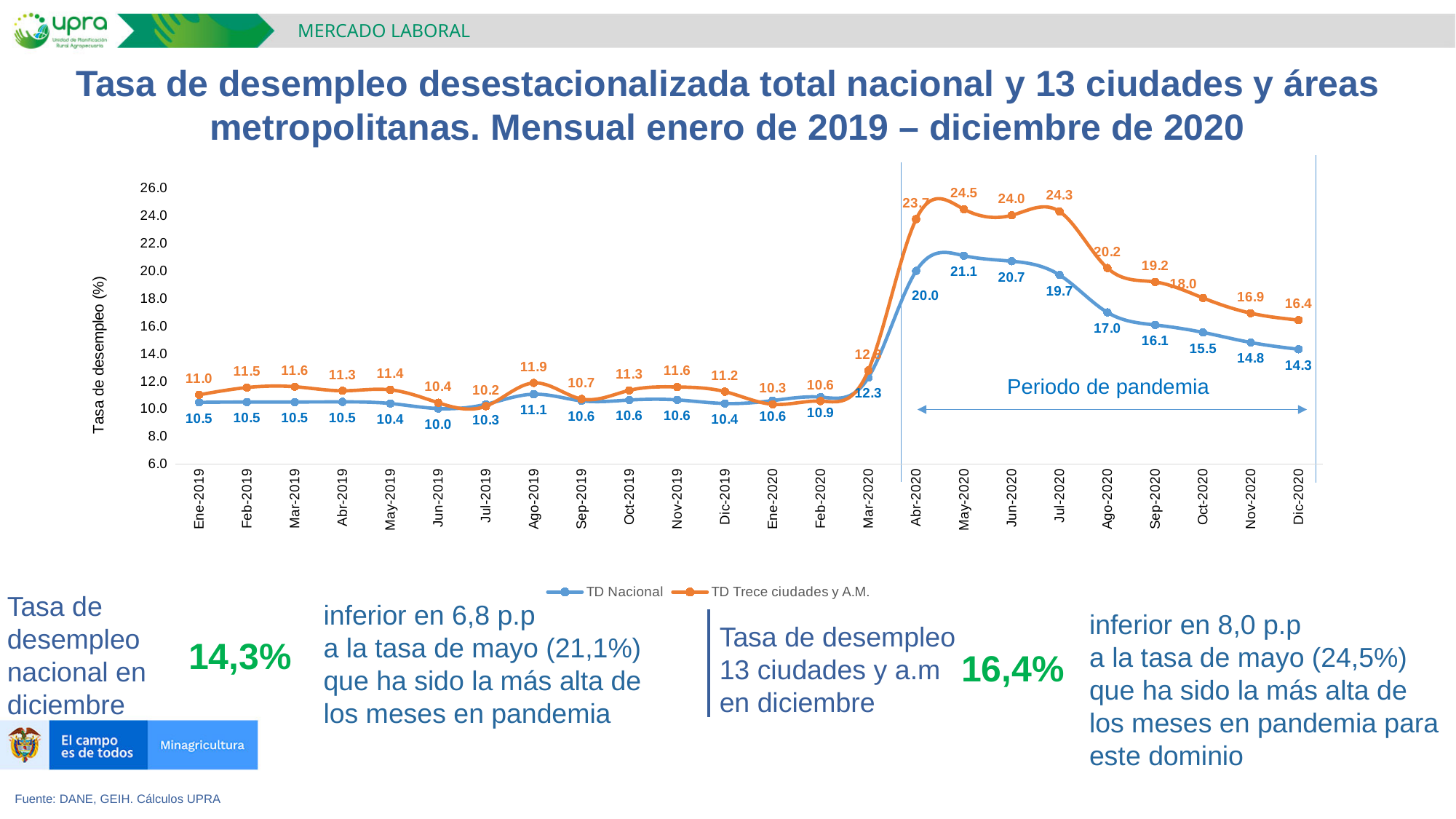
What kind of chart is shown on the slide? Line chart From May-2020 to Dic-2020, does TD Nacional rise or fall? Fall What is the difference between TD Trece ciudades y A.M. and TD Nacional in Dic-2020? 2.1 What is the value of TD Nacional in Dic-2020? 14.3 What is the value of TD Trece ciudades y A.M. in Dic-2020? 16.4 What is the value of TD Trece ciudades y A.M. in May-2020? 24.5 What is the difference between the TD Nacional value in May-2020 and in Dic-2020? 6.8 How many series does the legend list? 2 How many months are plotted on the x axis? 24 In which month does TD Nacional reach its lowest value? Jun-2019 In Ago-2019, which series has the higher value, TD Nacional or TD Trece ciudades y A.M.? TD Trece ciudades y A.M. In which month does TD Nacional reach its highest value? May-2020